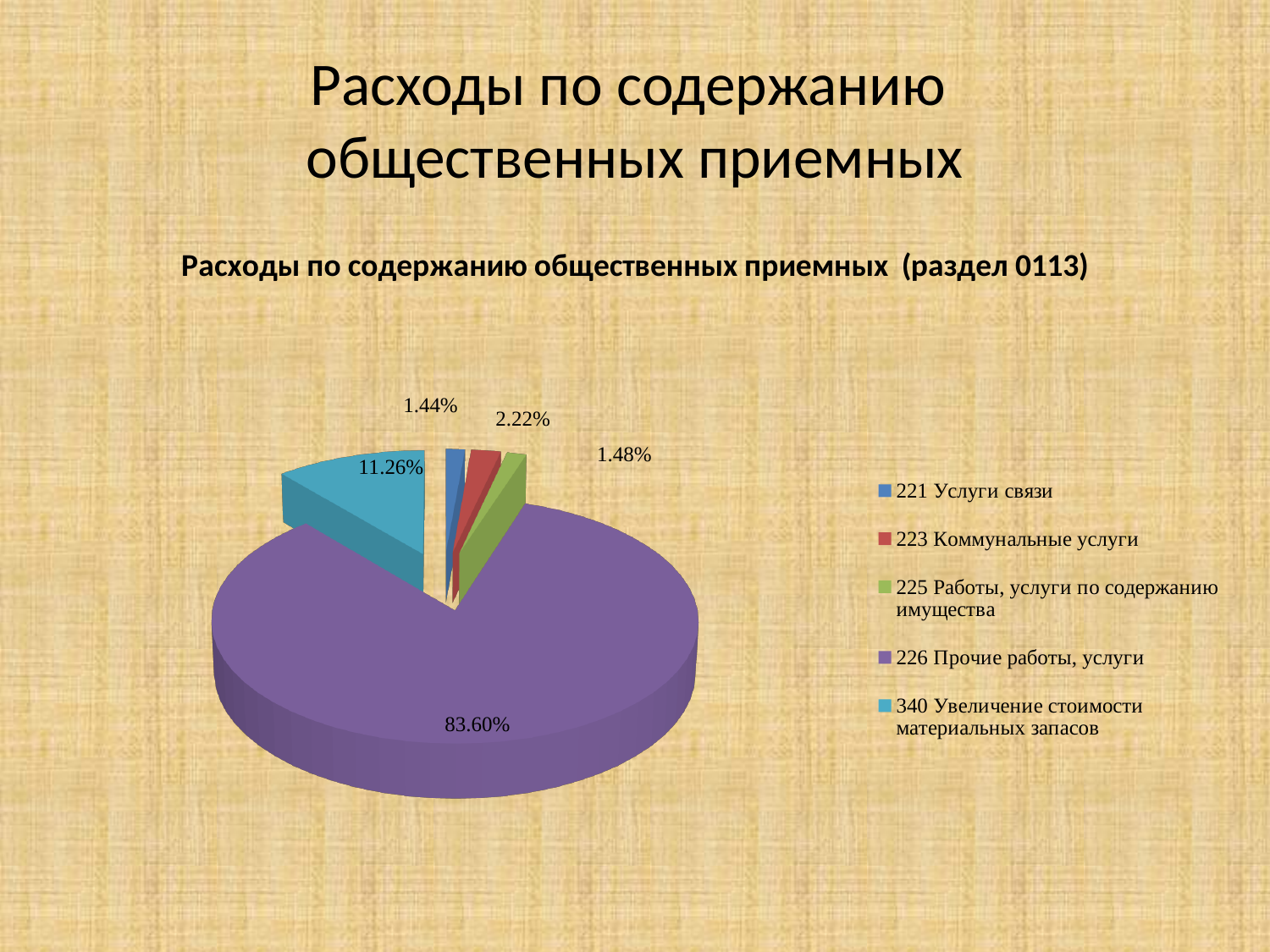
Which category has the largest share of the pie? 226 Прочие работы, услуги What kind of chart is shown on the slide? pie chart What share of the pie is '221 Услуги связи'? 1.44% Which is larger: the share of '223 Коммунальные услуги' or '225 Работы, услуги по содержанию имущества'? 223 Коммунальные услуги How many categories does the legend list? 5 What share of the pie is '225 Работы, услуги по содержанию имущества'? 1.48% What share of the pie is '223 Коммунальные услуги'? 2.22% Which category has the smallest share of the pie? 221 Услуги связи What is the chart's title? Расходы по содержанию общественных приемных (раздел 0113) What is the difference between the shares of '226 Прочие работы, услуги' and '340 Увеличение стоимости материальных запасов'? 72.34%